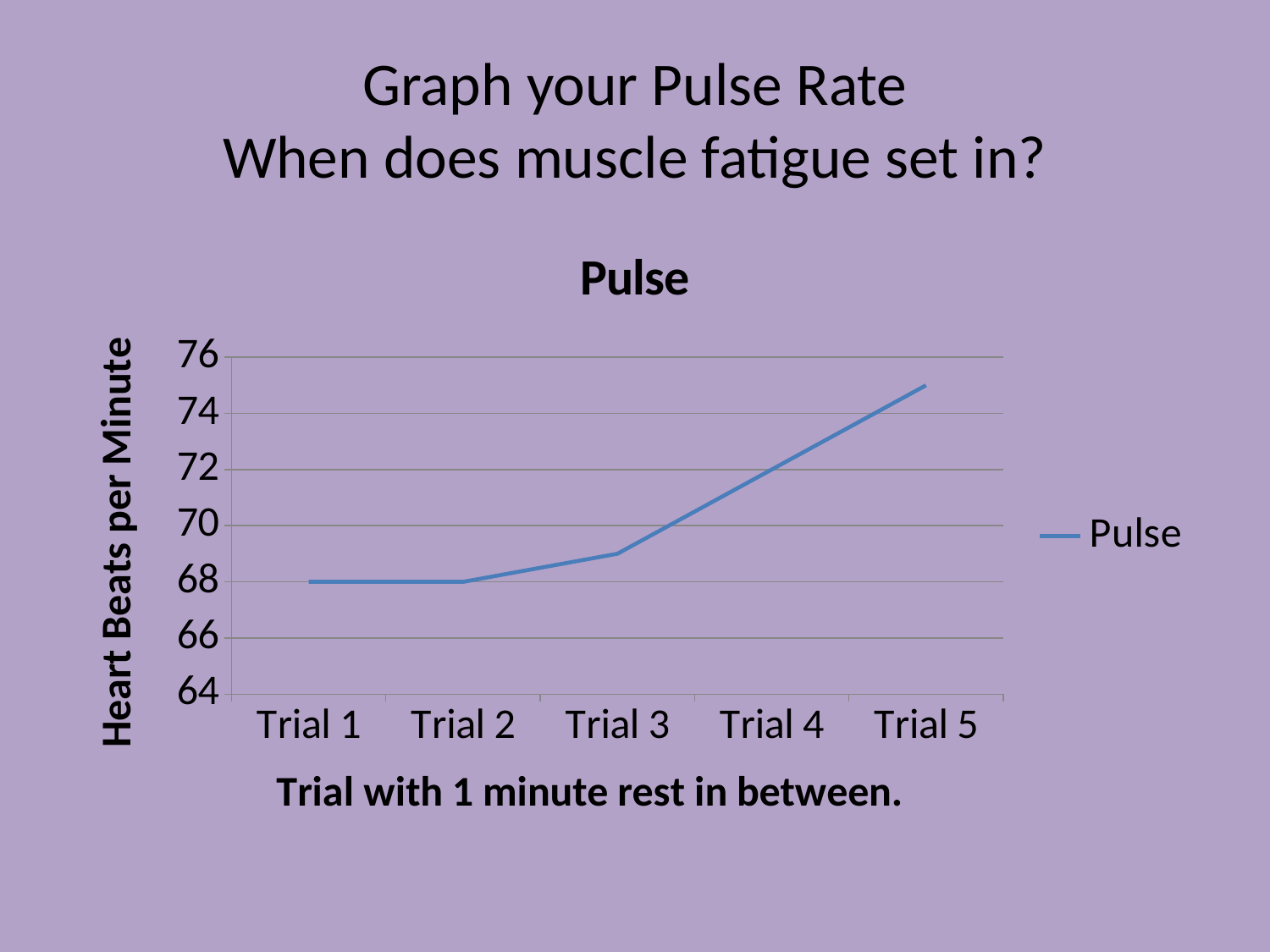
What kind of chart is shown on the slide? line chart Which has a higher pulse value, Trial 3 or Trial 5? Trial 5 How many trials are plotted on the x axis? 5 Do the pulse values rise or fall from Trial 1 to Trial 5? rise How many series does the legend list? 1 Is the value for Trial 4 greater or less than 70? greater Is the value for Trial 3 greater or less than 70? less What is the label of the y axis? Heart Beats per Minute What is the pulse value for Trial 1? 68 What is the pulse value for Trial 2? 68 Which trial has the highest pulse value? Trial 5 Is the value for Trial 5 greater or less than 74? greater